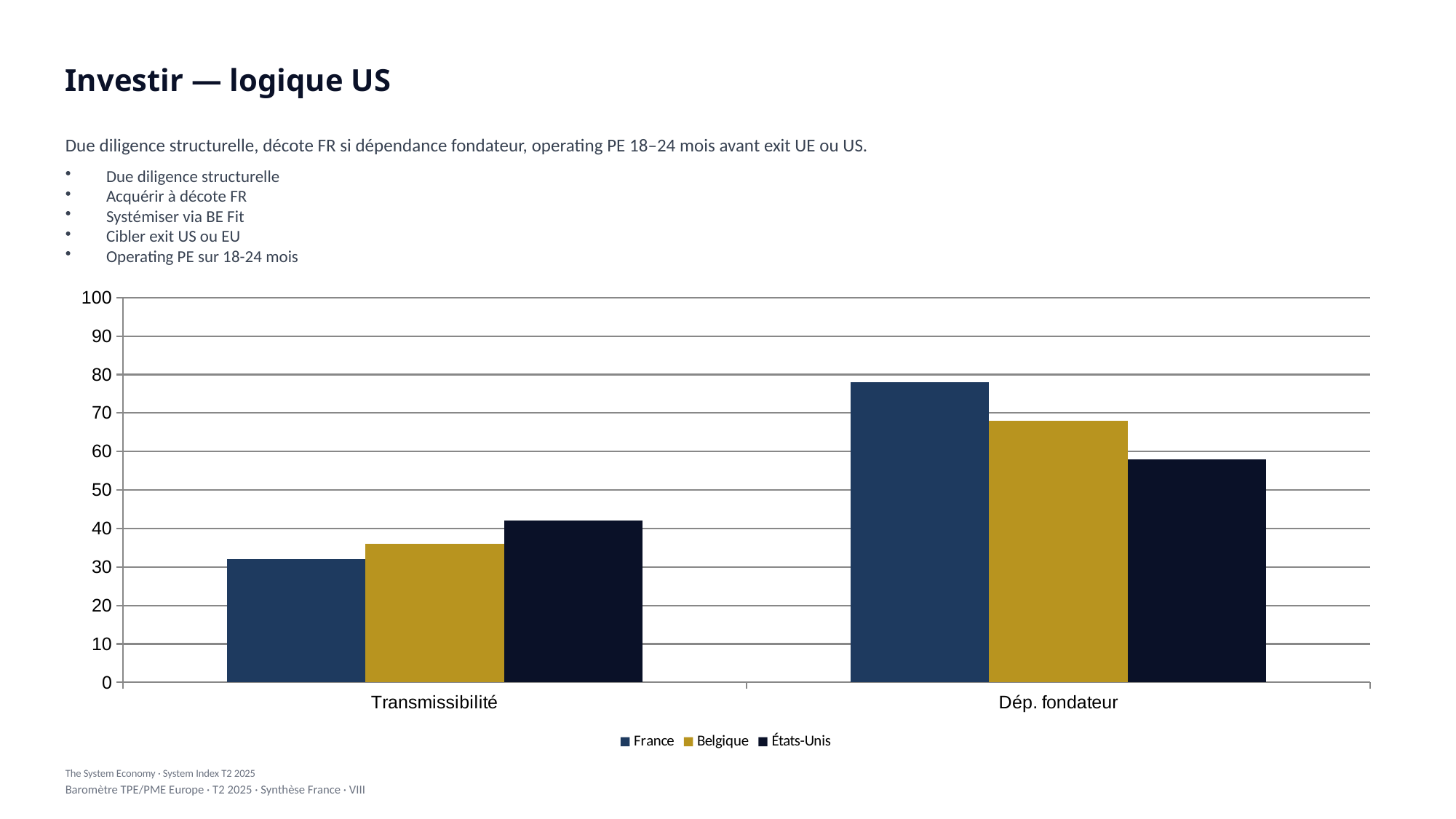
Which series is shown in gold/yellow in the chart legend? Belgique Is the value for États-Unis in Dép. fondateur greater or less than 50? greater Which series has the highest value for Dép. fondateur? France Is the value for France in Transmissibilité greater or less than 40? less How many categories are shown on the x axis of the chart? 2 What kind of chart is shown on the slide? bar chart Which series has the highest value for Transmissibilité? États-Unis How many series does the chart legend list? 3 Which series has the lowest value for Transmissibilité? France Is the value for France in Dép. fondateur greater or less than 70? greater Which series has the lowest value for Dép. fondateur? États-Unis For Belgique, which category has the larger value, Transmissibilité or Dép. fondateur? Dép. fondateur